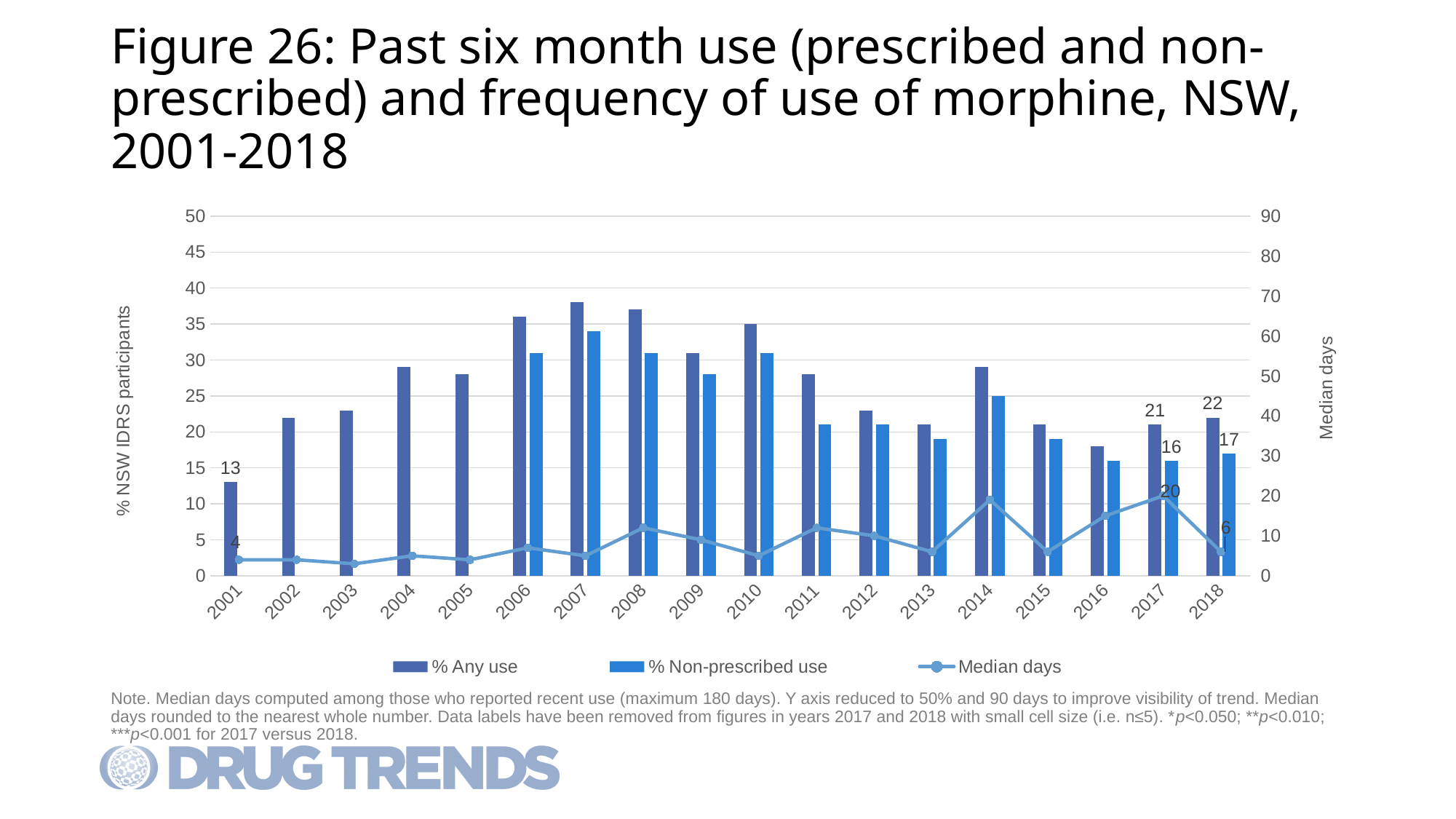
How many series does the legend list? 3 What is the Median days value for 2017? 20 What is the value of % Any use for 2001? 13 What is the Median days value for 2001? 4 Which is larger, % Any use in 2017 or in 2018? 2018 How many years are shown on the x axis? 18 What is the difference between % Any use and % Non-prescribed use in 2018? 5 Which year has the lowest % Any use bar? 2001 What is the value of % Non-prescribed use for 2018? 17 Is the % Any use value for 2016 greater or less than 20? less What is the difference in Median days between 2017 and 2018? 14 Which year has the highest % Any use bar? 2007